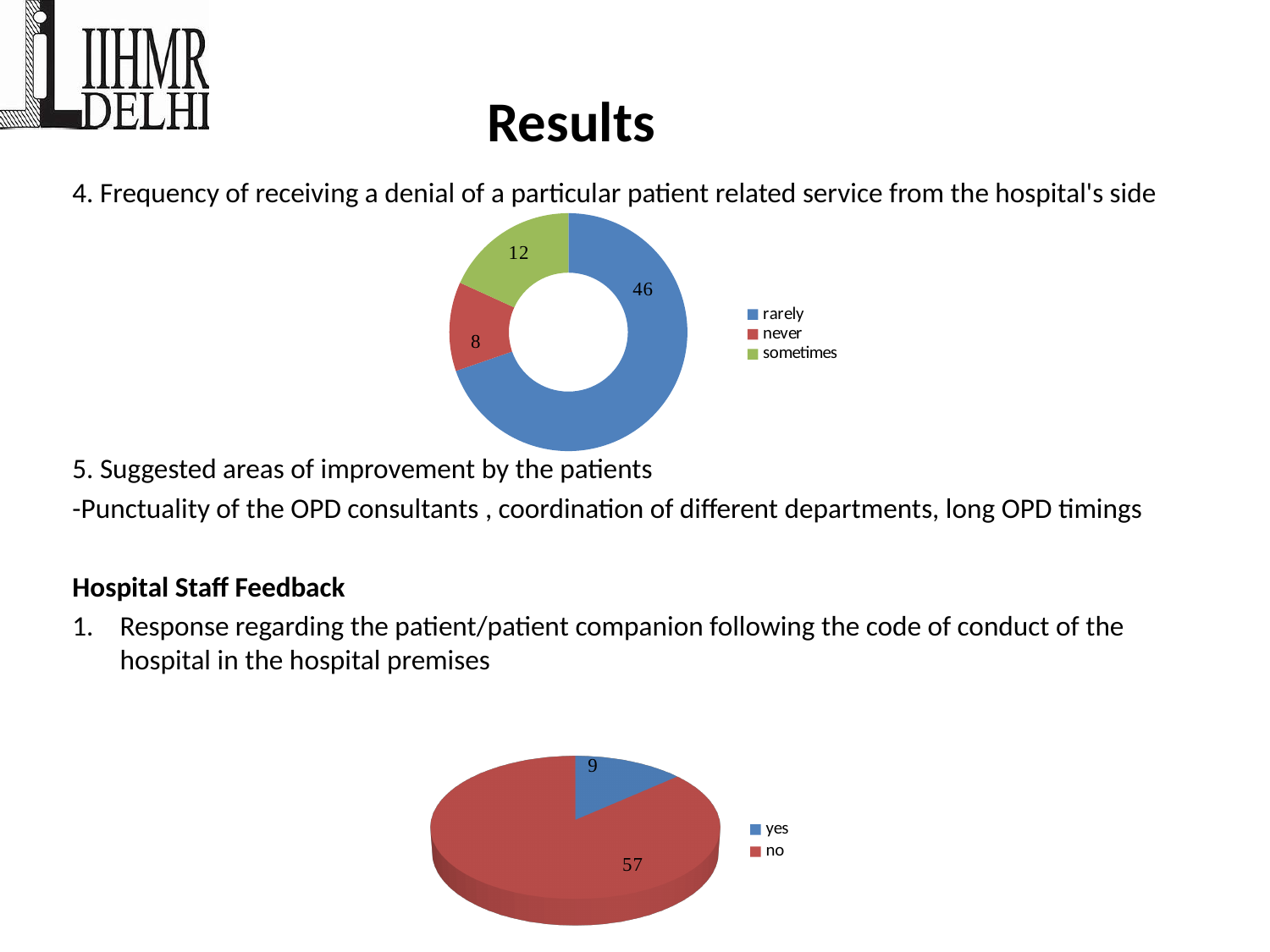
In the bottom chart, which is larger, "yes" or "no"? no In the bottom chart, what is the value for "yes"? 9 In the top chart, what is the difference between the values for "rarely" and "sometimes"? 34 In the top chart, which category has the smallest value? never In the bottom chart, what is the difference between the values for "no" and "yes"? 48 In the top chart, how many categories does the legend list? 3 In the top chart, what is the value for "never"? 8 In the top chart, what is the value for "sometimes"? 12 What kind of chart is the top chart? doughnut chart In the top chart, which category has the largest value? rarely In the bottom chart, what is the value for "no"? 57 In the top chart, what is the value for "rarely"? 46